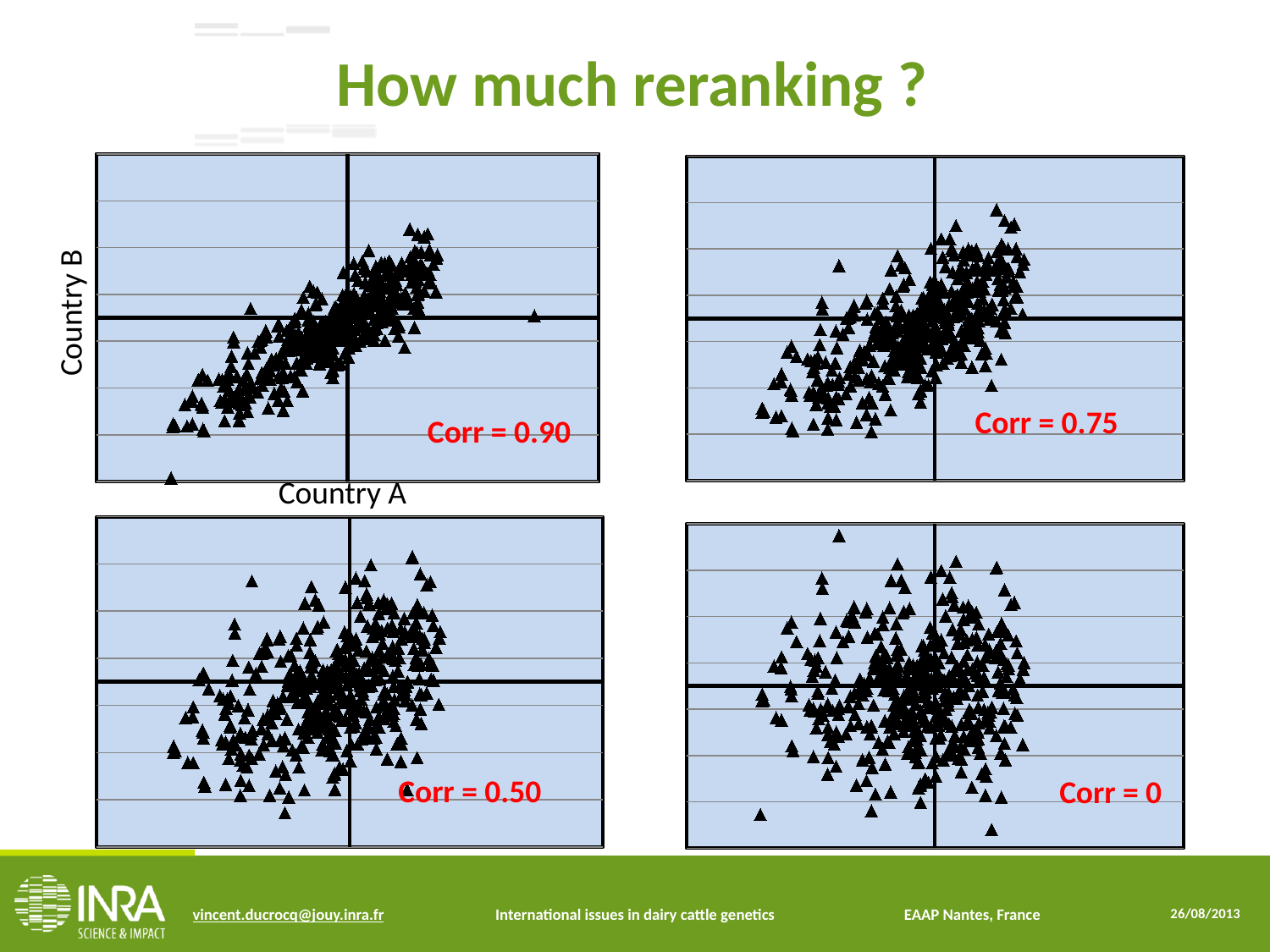
What correlation value is printed on the bottom-left scatter plot? Corr = 0.50 What is the label on the y axis of the top-left scatter plot? Country B How many scatter plots are shown on the slide? 4 What correlation value is printed on the top-right scatter plot? Corr = 0.75 What correlation value is printed on the bottom-right scatter plot? Corr = 0 Which of the four scatter plots has the lowest printed correlation? bottom-right (Corr = 0) In the top-left scatter plot, do the points tend to rise or fall as you move from left to right along the x axis? rise Which of the four scatter plots has the highest printed correlation? top-left (Corr = 0.90) Is the printed correlation of the top-right plot larger or smaller than that of the bottom-left plot? larger What correlation value is printed on the top-left scatter plot? Corr = 0.90 What is the label on the x axis of the top-left scatter plot? Country A What kind of chart is shown in the top-left panel? scatter plot